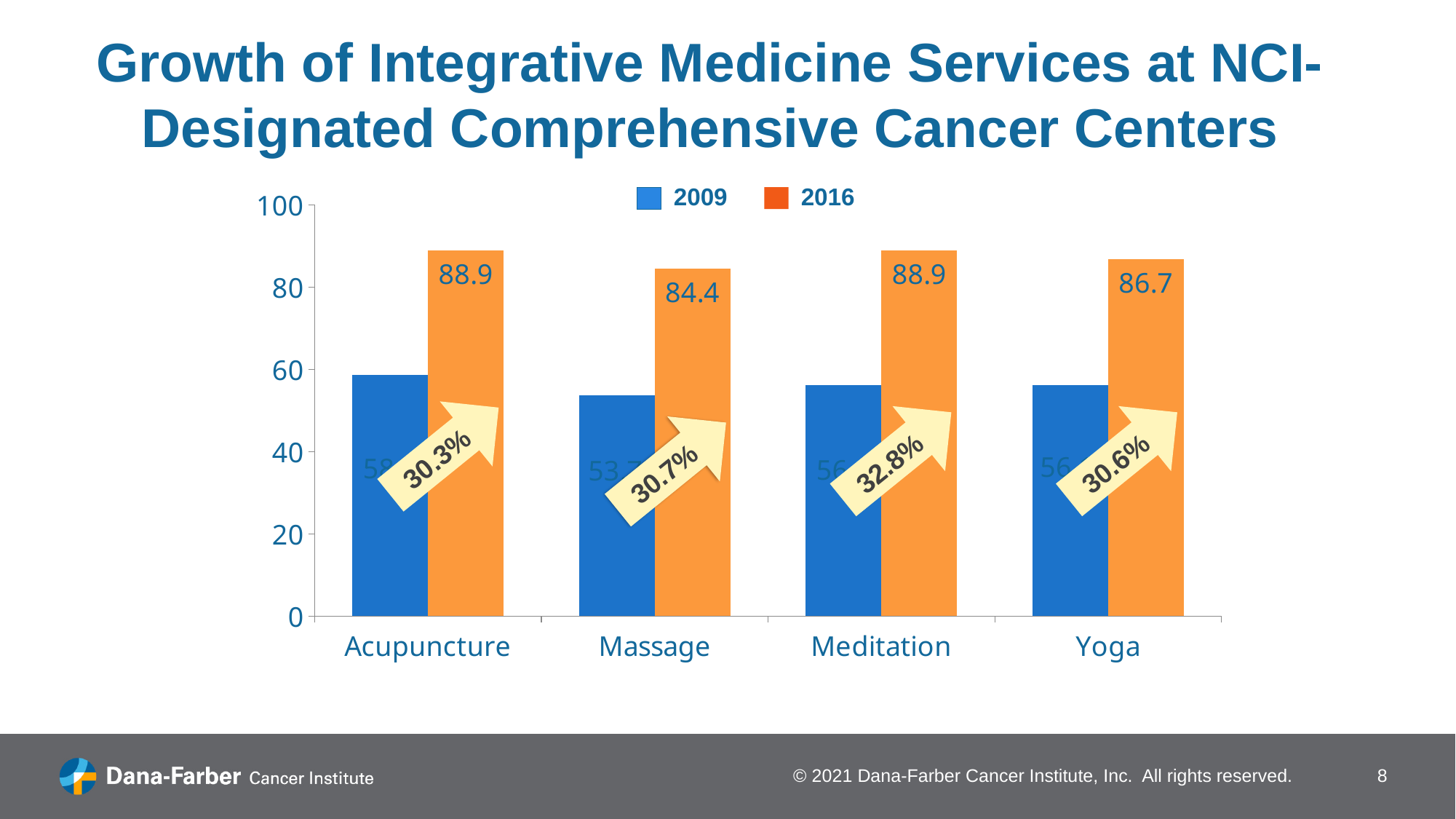
What kind of chart is shown on the slide? bar chart Is the 2009 value for Massage greater or less than 60? less Which has the larger 2016 value, Meditation or Yoga? Meditation What is the 2016 value for Massage? 84.4 What is the 2016 value for Acupuncture? 88.9 Is the 2009 value for Acupuncture greater or less than 40? greater How many categories are shown on the x axis? 4 What growth percentage is shown on the arrow for Meditation? 32.8% What is the difference between the 2016 values for Acupuncture and Massage? 4.5 How many series does the legend list? 2 What is the 2016 value for Yoga? 86.7 Which category has the lowest 2016 value? Massage